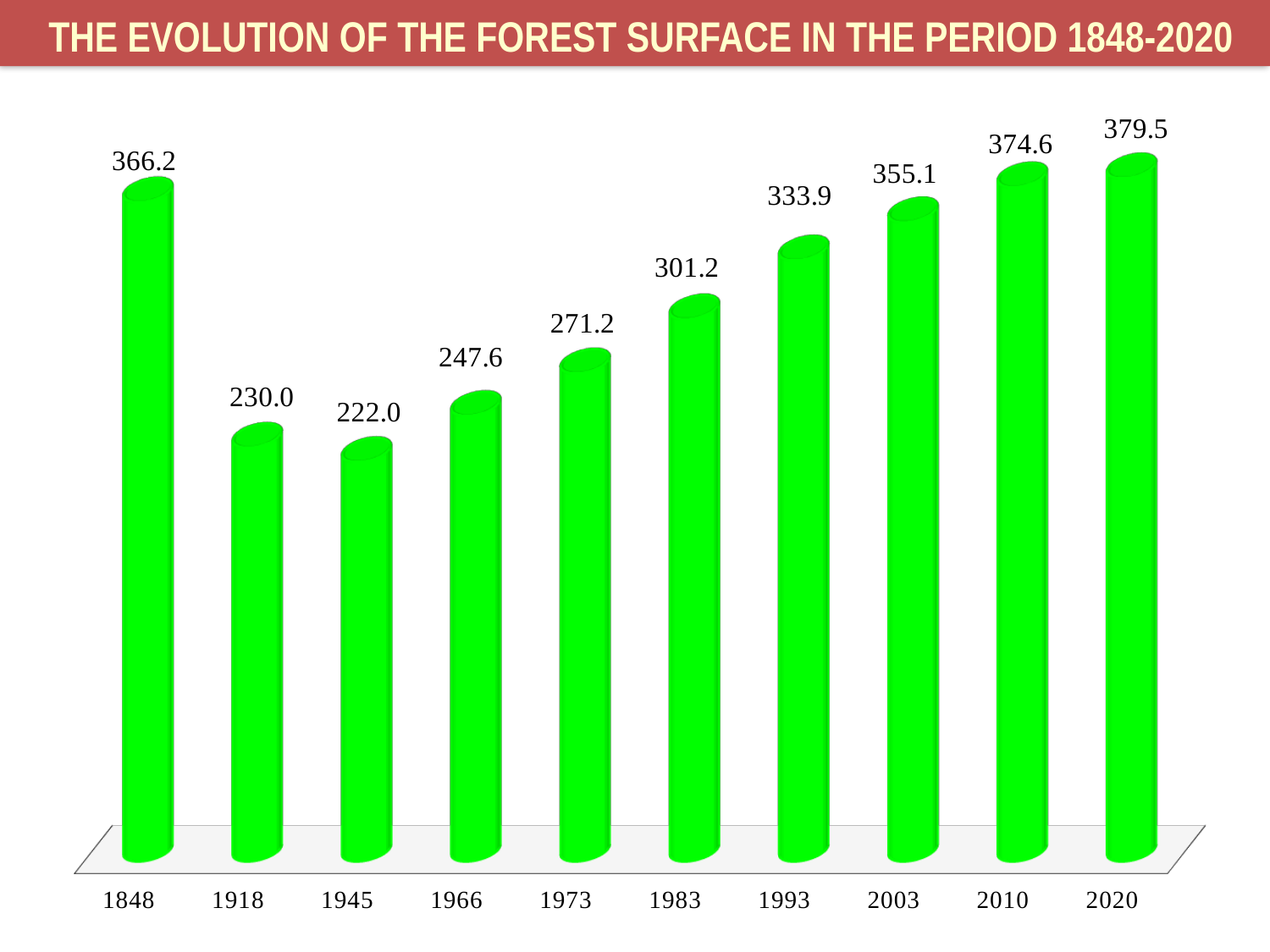
Do the values rise or fall from 1945 to 2020? rise Which year has the highest value? 2020 What is the difference between the values for 1848 and 1918? 136.2 What kind of chart is this? bar chart Which is larger, the value for 1848 or the value for 2003? 1848 What is the forest surface value shown for 1848? 366.2 Which year has the lowest value? 1945 How many years are shown on the x axis? 10 What is the value shown for 1993? 333.9 What is the value shown for 2020? 379.5 What is the title of the chart? THE EVOLUTION OF THE FOREST SURFACE IN THE PERIOD 1848-2020 What is the difference between the values for 2020 and 1945? 157.5